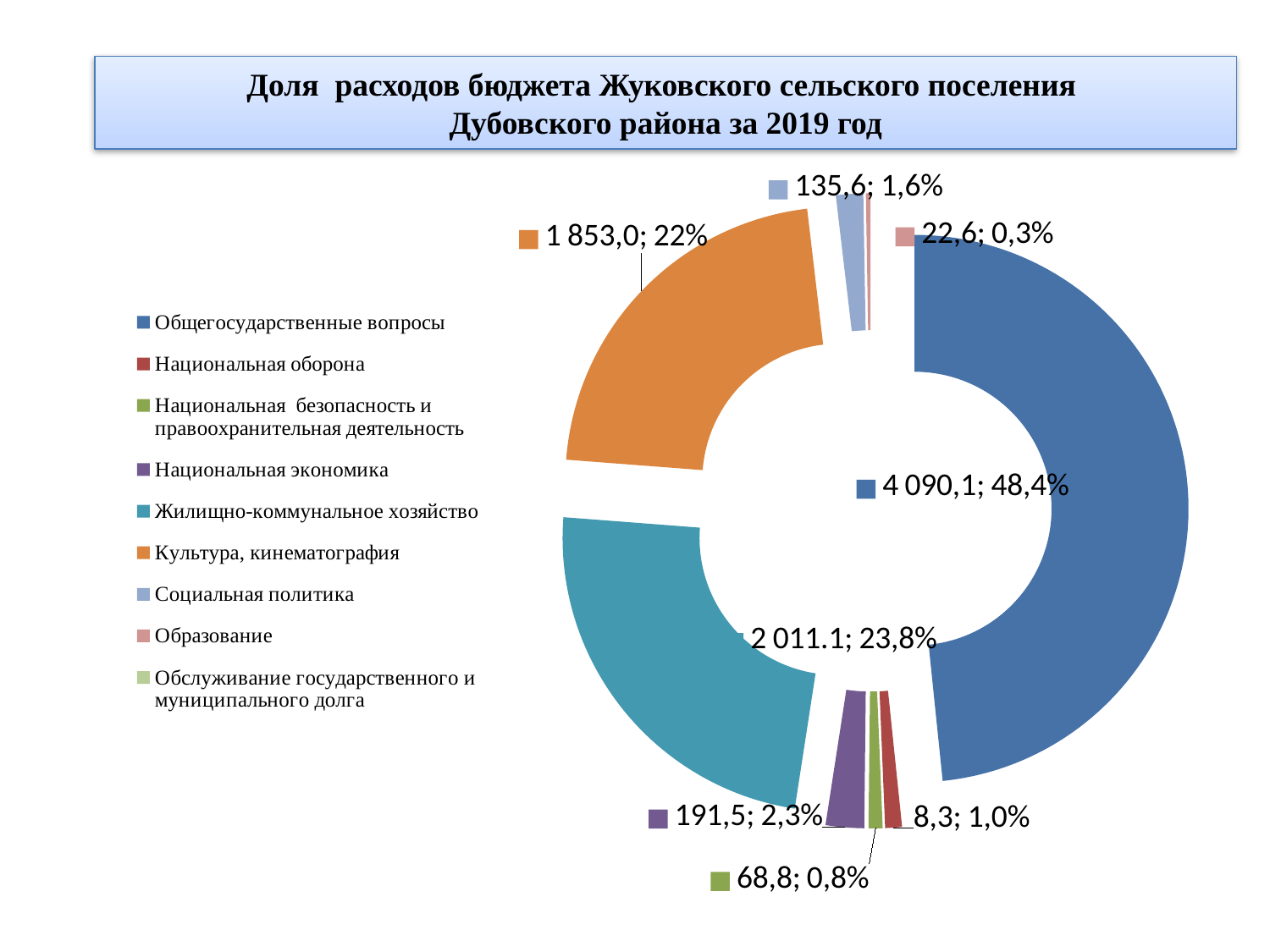
What value is shown for Национальная экономика? 191,5 What share is shown for Национальная безопасность и правоохранительная деятельность? 0,8% What share of the budget expenses does Жилищно-коммунальное хозяйство account for? 23,8% What value is shown for Образование? 22,6 How many categories does the legend list? 9 What is the difference in percentage points between the shares of Общегосударственные вопросы and Жилищно-коммунальное хозяйство? 24,6 What kind of chart is shown on the slide? Doughnut (pie) chart Which category has the largest share of expenses? Общегосударственные вопросы What value is shown for Культура, кинематография? 1 853,0 Which is larger: the share for Жилищно-коммунальное хозяйство or for Культура, кинематография? Жилищно-коммунальное хозяйство What value and share are shown for Общегосударственные вопросы? 4 090,1; 48,4% What share is shown for Социальная политика? 1,6%